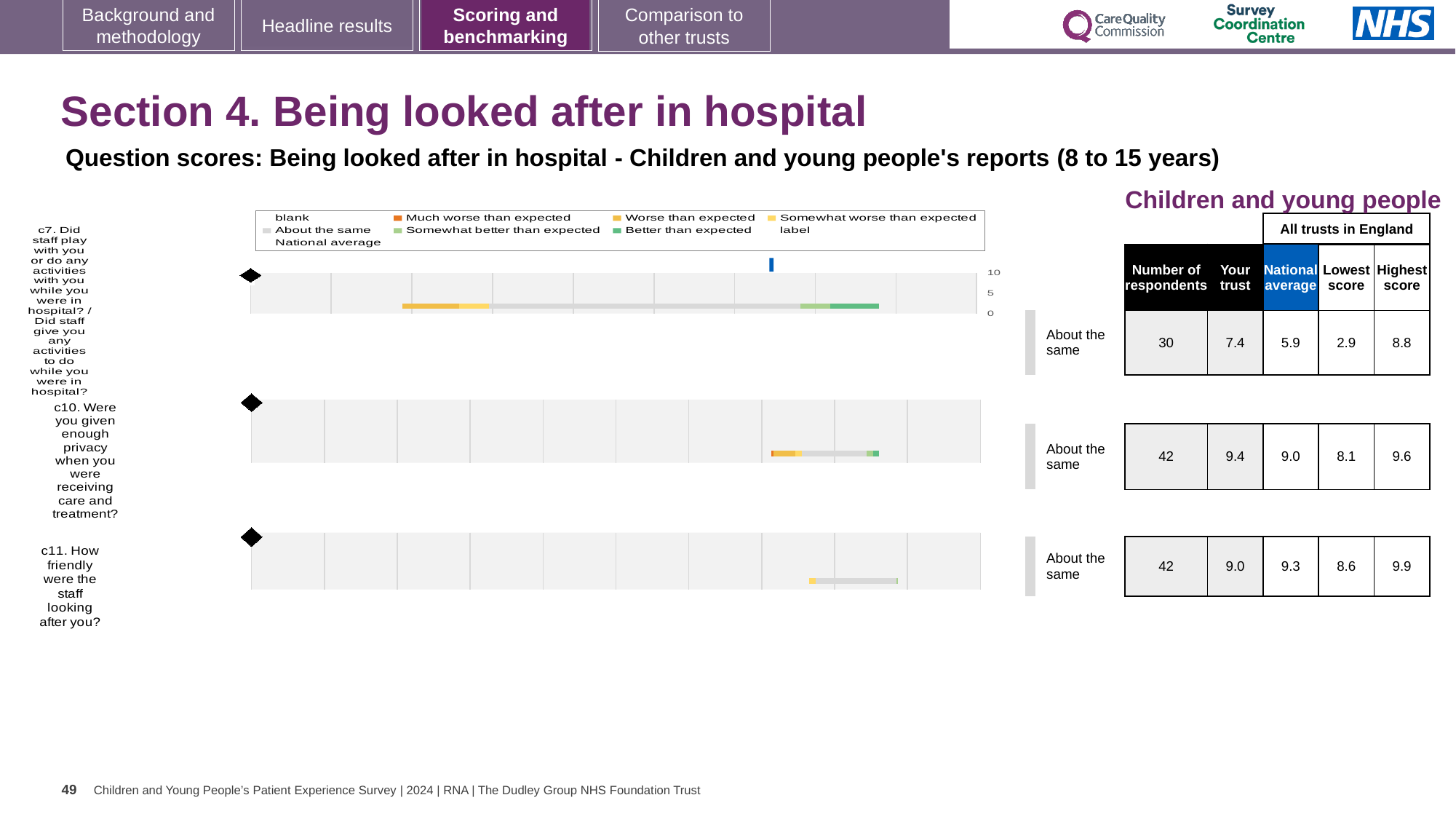
What is the national average score for question c11 (How friendly were the staff looking after you?)? 9.3 What kind of chart is used to show the question scores on this slide? Bar chart For question c7, what is the difference between the highest score and the lowest score among all trusts in England? 5.9 For question c11, which is larger: the 'Your trust' score or the national average? National average Which question has the lowest national average score? c7 For question c10, how much higher is the 'Your trust' score than the national average? 0.4 Which question has the highest 'Your trust' score? c10 What is the lowest score among all trusts in England for question c10? 8.1 What benchmark category is shown for question c7? About the same How many questions are plotted on this slide? 3 How many respondents answered question c7 (Did staff play with you or do any activities with you while you were in hospital?)? 30 What is the 'Your trust' score for question c10 (Were you given enough privacy when you were receiving care and treatment?)? 9.4